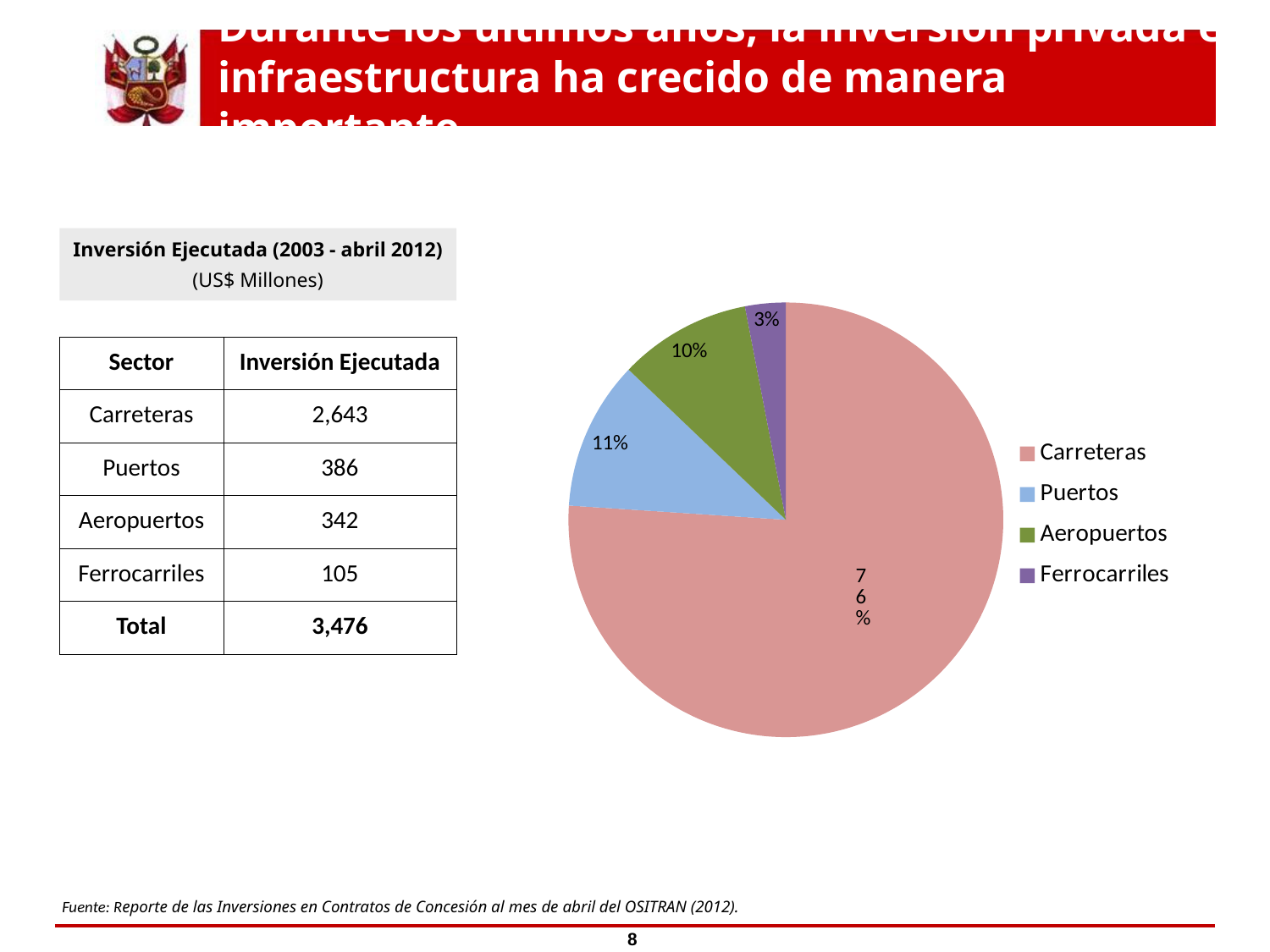
What share of the pie does Aeropuertos represent? 10% Which sector has the largest slice of the pie? Carreteras What is the difference in percentage points between the Carreteras slice and the Puertos slice? 65 How many slices does the pie chart have? 4 What share of the pie does Puertos represent? 11% Which slice is larger, Puertos or Ferrocarriles? Puertos What share of the pie does Carreteras represent? 76% How many entries does the legend of the pie chart list? 4 What colour is the Aeropuertos slice in the pie chart? green Which sector has the smallest slice of the pie? Ferrocarriles What kind of chart is shown on the slide? pie chart